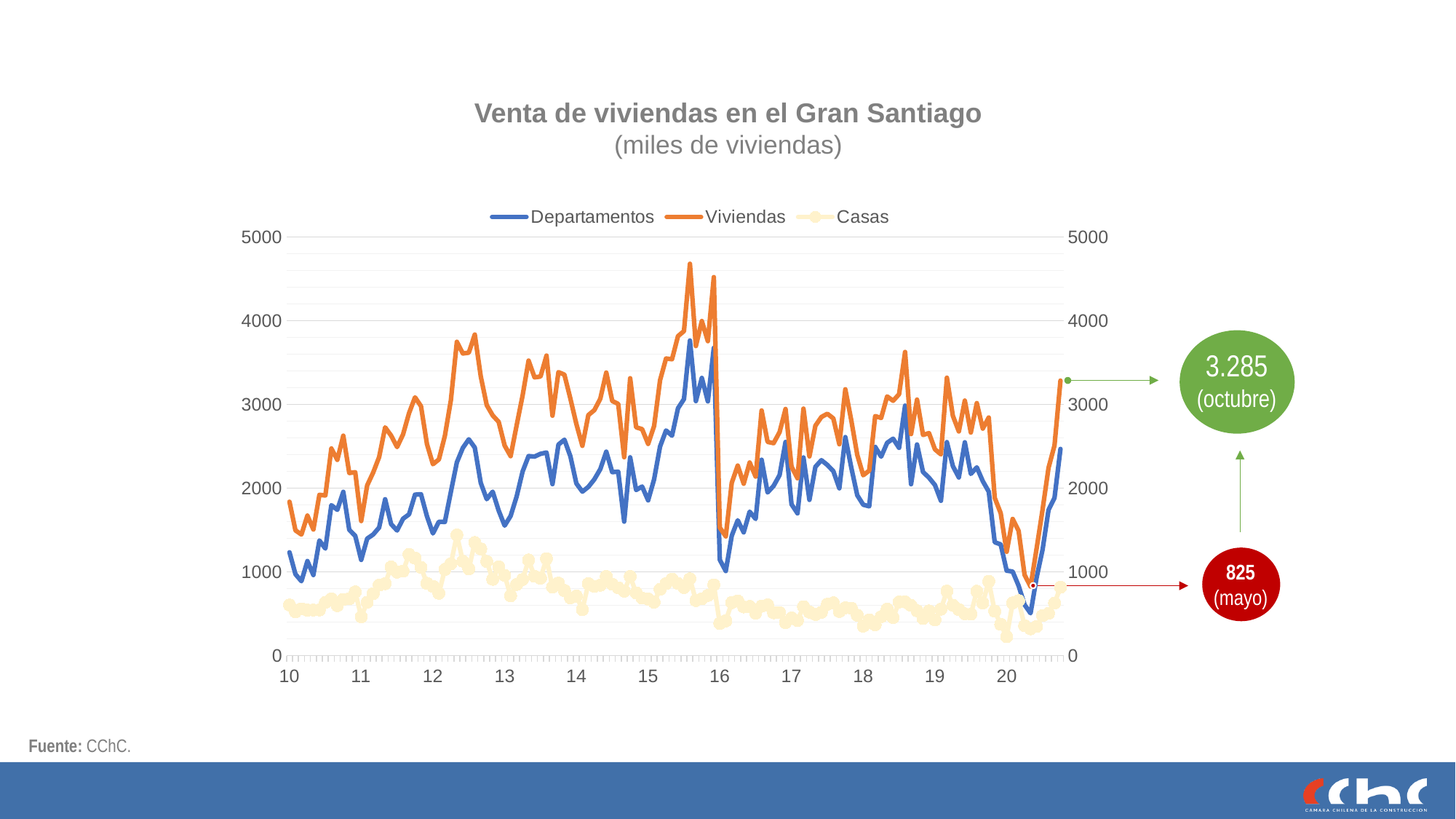
Which series has the highest values across the whole chart? Viviendas Is the highest peak of the Viviendas series, around 2015, greater or less than 4000? greater Does the Viviendas series rise or fall between May 2020 and October 2020? rise Which series has the lowest values across the whole chart? Casas Is the value of the Casas series at the start of 2010 greater or less than 1000? less What kind of chart is shown on the slide? line chart How many series does the legend list? 3 What is the value of the Viviendas series in October (octubre) 2020, as annotated on the slide? 3.285 What is the value of the Viviendas series in May (mayo) 2020, as annotated on the slide? 825 What is the title of the chart? Venta de viviendas en el Gran Santiago (miles de viviendas) What colour is the Departamentos line in the chart? blue What is the difference between the annotated October value (3.285) and the annotated May value (825) for Viviendas? 2.460